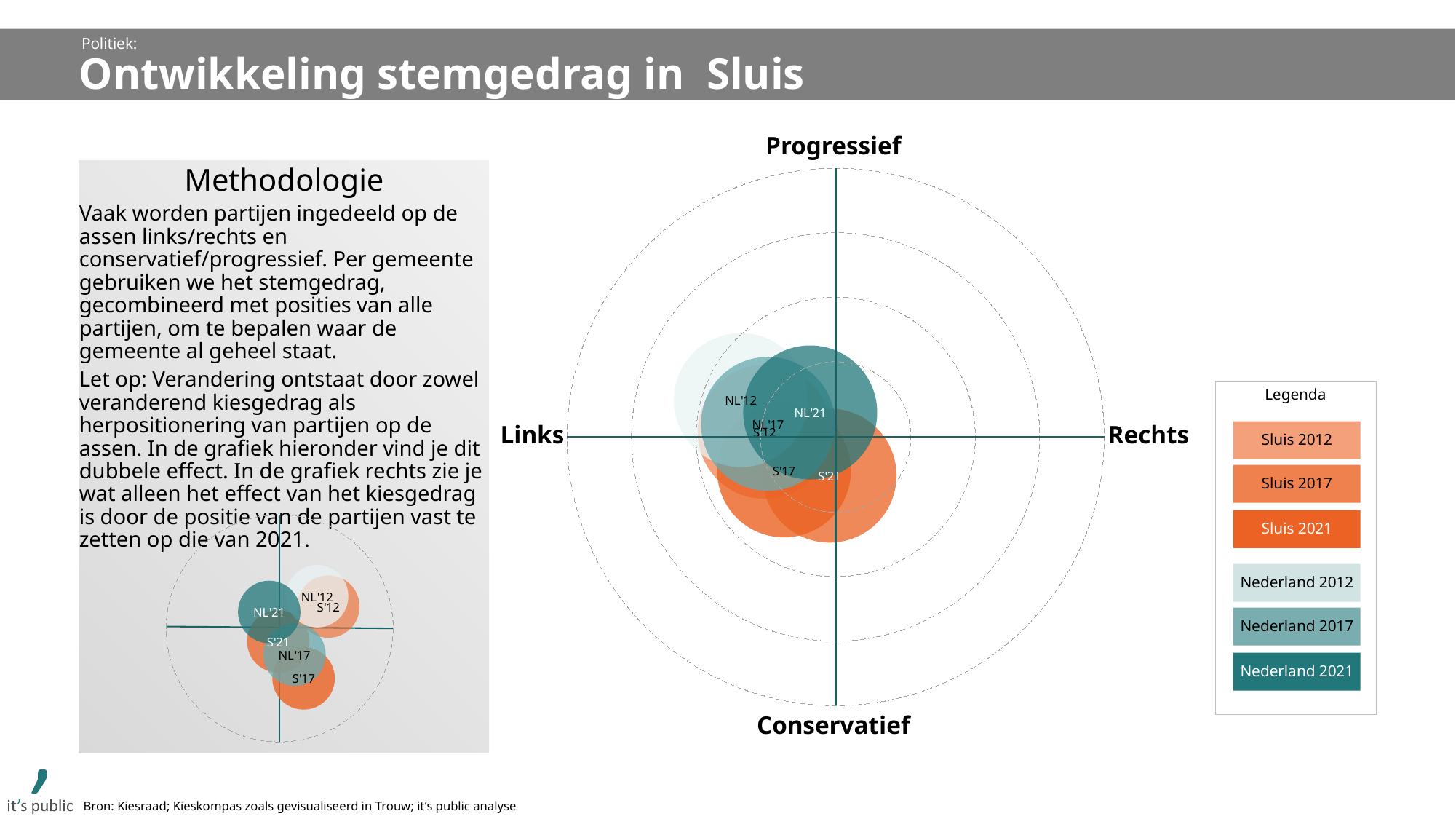
How many entries does the legend (Legenda) list? 6 In the small chart inside the Methodologie box, is the bubble NL'21 on the Links or the Rechts side of the vertical axis? Links In the large chart on the right, what is the label at the right end of the horizontal axis? Rechts In the small chart inside the Methodologie box, is the bubble S'12 in the progressive or the conservative half? Progressief In the large chart on the right, is the bubble S'17 in the progressive or the conservative half? Conservatief What kind of chart is the large chart on the right of the slide? Bubble chart How many charts are shown on the slide? 2 In the large chart on the right, how many labelled bubbles are plotted? 6 In the large chart on the right, what is the label at the top of the vertical axis? Progressief